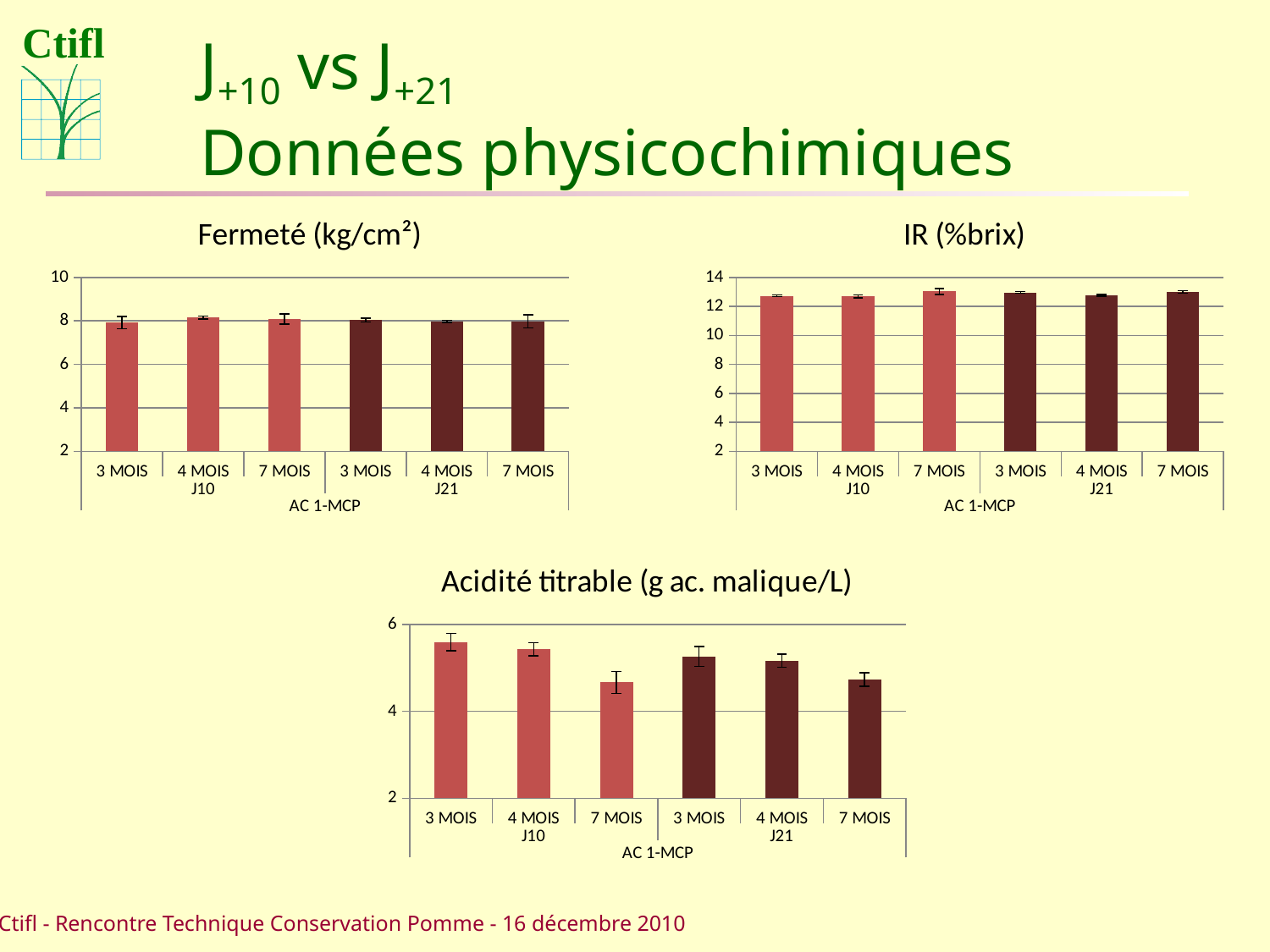
In the "Acidité titrable (g ac. malique/L)" chart, which is larger: 3 MOIS under J10 or 7 MOIS under J10? 3 MOIS under J10 In the "IR (%brix)" chart, is the value for 7 MOIS under J21 greater or less than 14? less In the "Acidité titrable (g ac. malique/L)" chart, is the value for 3 MOIS under J10 greater or less than 6? less In the "IR (%brix)" chart, is the value for 3 MOIS under J10 greater or less than 12? greater How many charts are shown on the slide? 3 In the "Acidité titrable (g ac. malique/L)" chart, which is larger: 3 MOIS under J21 or 7 MOIS under J21? 3 MOIS under J21 What kind of chart is the "Fermeté (kg/cm²)" chart? bar chart In the "Acidité titrable (g ac. malique/L)" chart, how many bars are plotted? 6 In the "Acidité titrable (g ac. malique/L)" chart, do the values rise or fall from 3 MOIS to 7 MOIS within the J10 group? fall What is the title of the chart in the top right of the slide? IR (%brix)